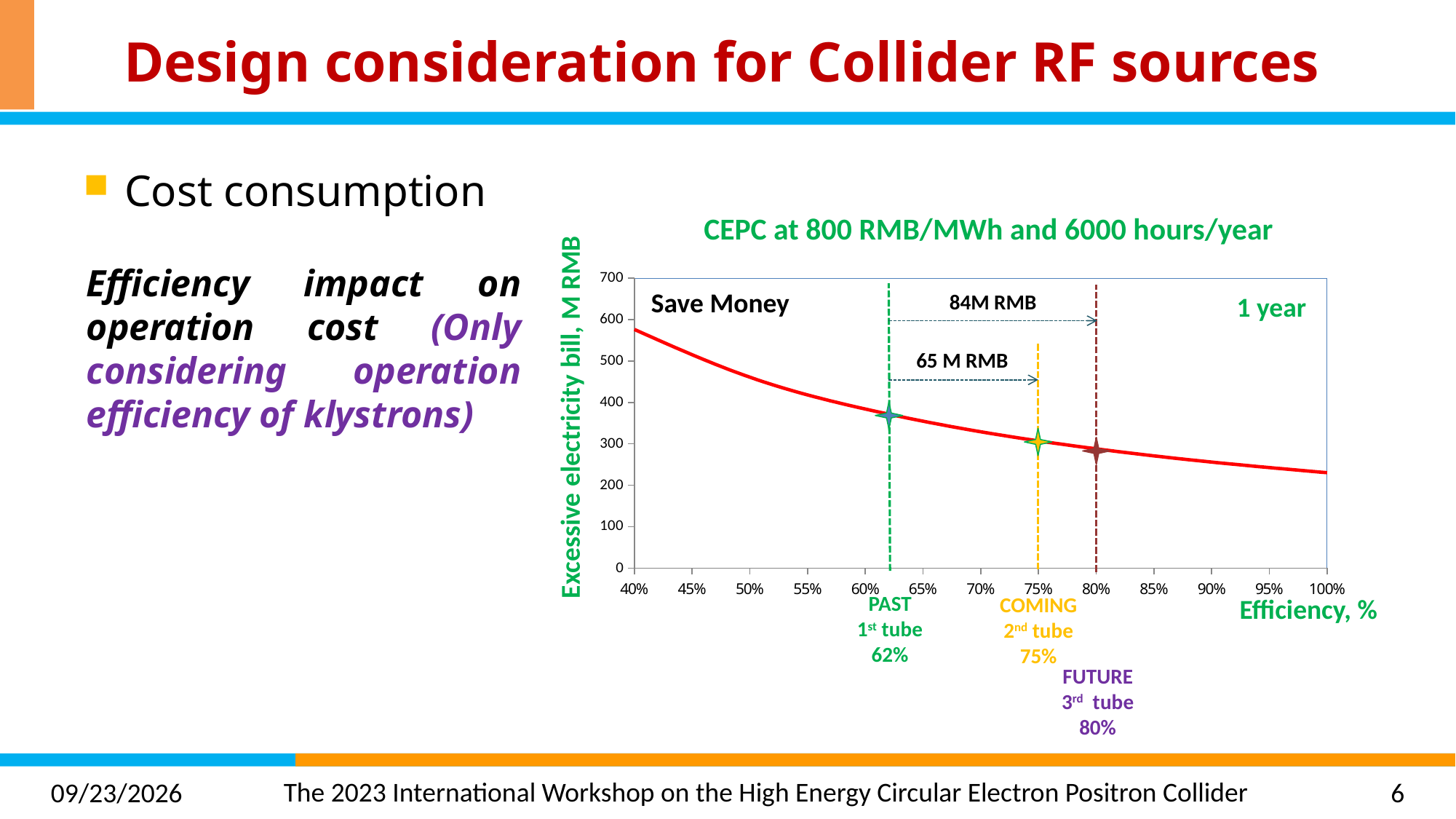
How much money is saved per year by going from 62% to 75% efficiency, according to the annotation? 65 M RMB What is the title of the chart? CEPC at 800 RMB/MWh and 6000 hours/year Is the excessive electricity bill at 100% efficiency greater or less than 300 M RMB? less What efficiency is marked for the COMING 2nd tube? 75% Is the excessive electricity bill at 62% efficiency greater or less than 300 M RMB? greater What is the label of the vertical axis of the chart? Excessive electricity bill, M RMB Does the excessive electricity bill rise or fall as efficiency increases along the x axis? fall What kind of chart is shown on the slide? line chart How much money is saved per year by going from 62% to 80% efficiency, according to the annotation? 84M RMB How many tube efficiency points are marked on the curve? 3 What efficiency is marked for the PAST 1st tube? 62% What efficiency is marked for the FUTURE 3rd tube? 80%